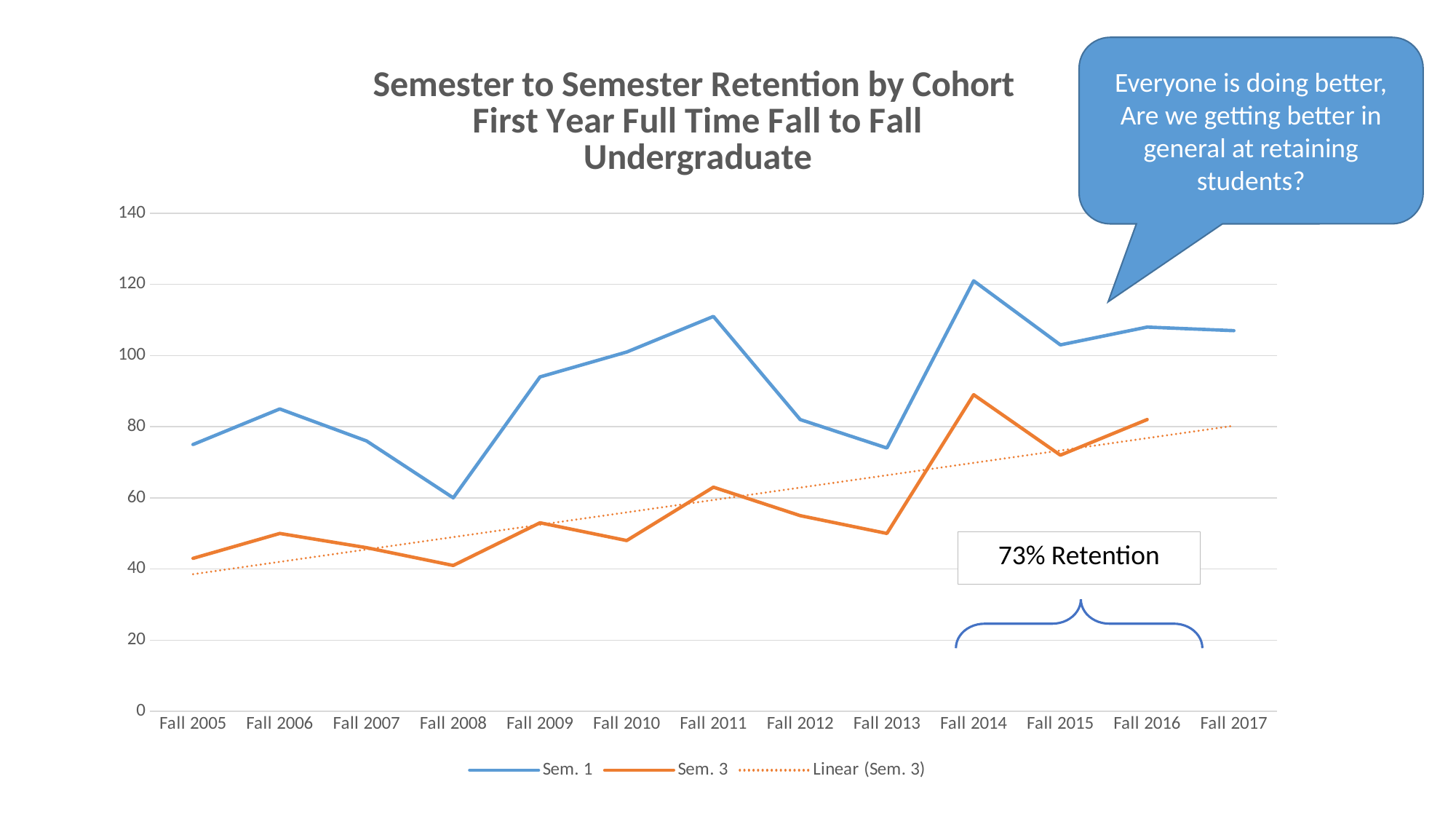
Does the Linear (Sem. 3) trend line rise or fall from Fall 2005 to Fall 2017? rise What retention percentage is stated in the annotation box above the bracket on the right of the chart? 73% Retention What kind of chart is shown on the slide? line chart Is the Sem. 1 value for Fall 2011 greater or less than 100? greater In which cohort does the Sem. 1 line reach its highest value? Fall 2014 In which cohort does the Sem. 1 line reach its lowest value? Fall 2008 Is the Sem. 3 value for Fall 2014 greater or less than 80? greater In which cohort does the Sem. 3 line reach its highest value? Fall 2014 How many series does the legend list? 3 Is the Sem. 3 value for Fall 2005 greater or less than 60? less For Fall 2009, which series has the larger value, Sem. 1 or Sem. 3? Sem. 1 How many cohorts (Fall terms) are shown on the x axis? 13